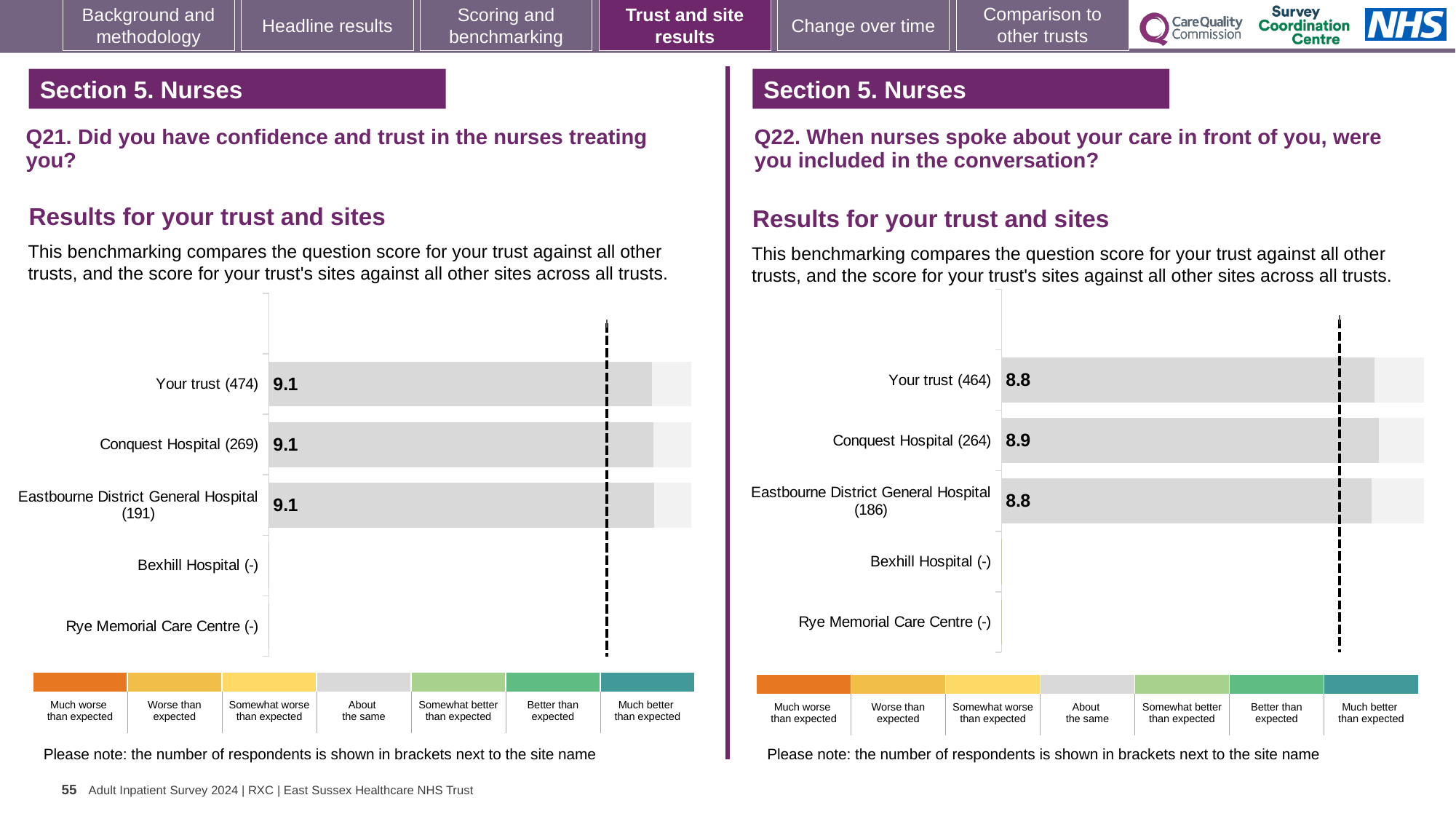
In the Q21 chart on the left, what is the score for Eastbourne District General Hospital (191)? 9.1 What kind of chart is the Q21 chart on the left? Bar chart In the Q21 chart on the left, what is the score for Your trust (474)? 9.1 In the Q21 chart on the left, how many respondents are shown for Conquest Hospital? 269 In the Q22 chart on the right, what is the score for Conquest Hospital (264)? 8.9 In the Q22 chart on the right, what is the difference between the scores for Conquest Hospital (264) and Your trust (464)? 0.1 In the Q22 chart on the right, which is larger: the score for Conquest Hospital (264) or the score for Eastbourne District General Hospital (186)? Conquest Hospital (264) In the Q22 chart on the right, which two sites show no score (-)? Bexhill Hospital and Rye Memorial Care Centre In the Q22 chart on the right, what is the score for Eastbourne District General Hospital (186)? 8.8 In the Q21 chart on the left, how many categories are listed on the vertical axis? 5 In the Q22 chart on the right, which site has the highest score? Conquest Hospital (264) In the Q22 chart on the right, what is the score for Your trust (464)? 8.8